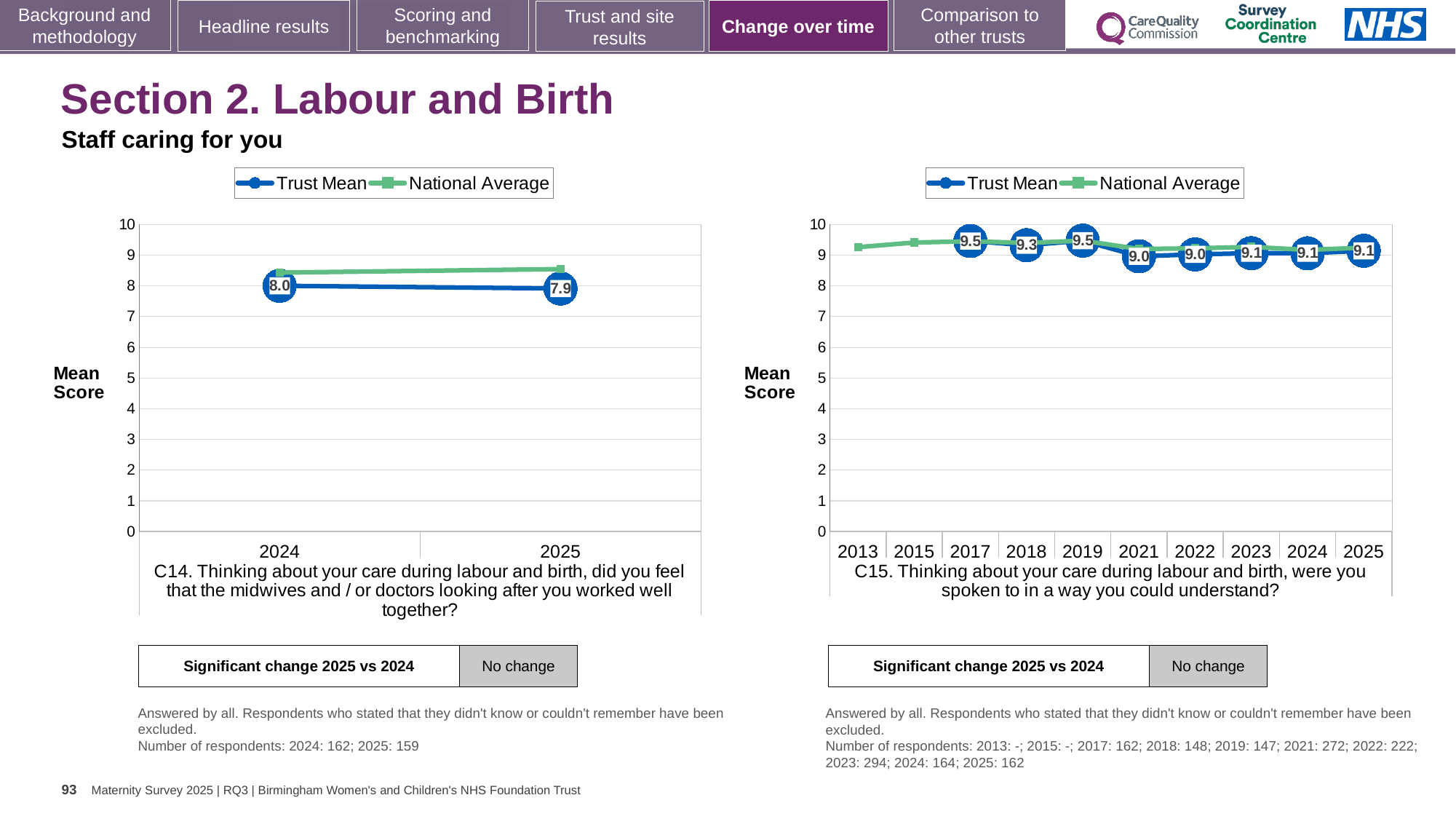
In the C14 chart on the left, what is the Trust Mean score for 2024? 8.0 In the C14 chart on the left, is the National Average for 2025 greater or less than 8? greater In the C15 chart on the right, which year has the lowest labelled Trust Mean score? 2021 and 2022 (9.0) In the C15 chart on the right, what is the Trust Mean score for 2021? 9.0 In the C14 chart on the left, what is the Trust Mean score for 2025? 7.9 In the C15 chart on the right, what is the difference between the Trust Mean in 2019 and in 2025? 0.4 In the C14 chart on the left, which series is higher in 2025, Trust Mean or National Average? National Average In the C15 chart on the right, how many years are shown on the x axis? 10 How many series does the legend of the C15 chart on the right list? 2 In the C14 chart on the left, by how much did the Trust Mean change from 2024 to 2025? 0.1 In the C15 chart on the right, what is the Trust Mean score for 2018? 9.3 What type of chart is the C14 chart on the left? Line chart